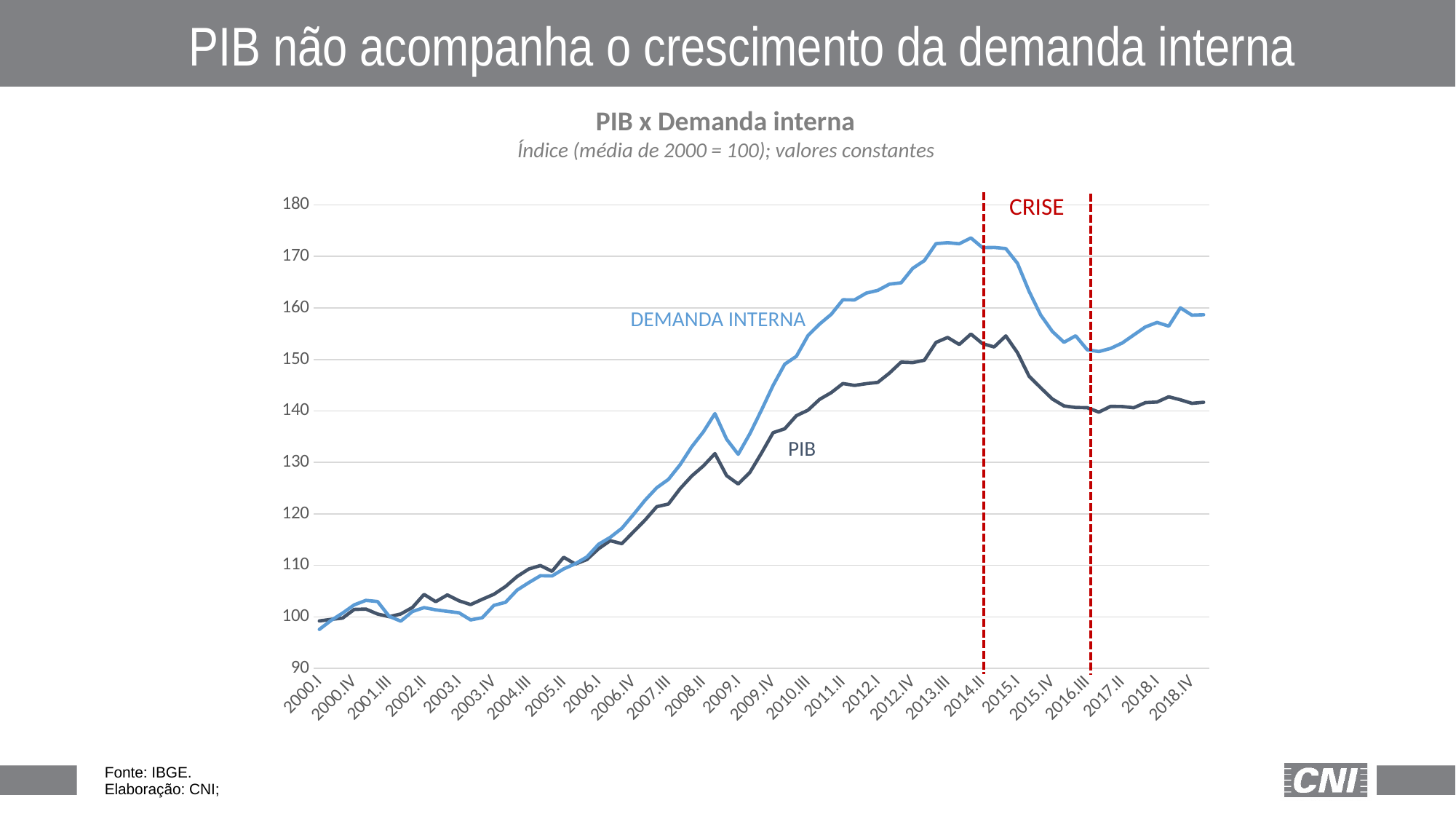
Is the value of DEMANDA INTERNA at 2018.IV greater or less than 150? greater At 2018.IV, which series has the higher value, PIB or DEMANDA INTERNA? DEMANDA INTERNA What word is written in red between the two dashed vertical lines? CRISE What kind of chart is shown on the slide? Line chart Is the value of PIB at 2000.I greater or less than 110? less Is the value of DEMANDA INTERNA at 2013.III greater or less than 170? greater How many series are plotted in the chart? 2 What is the title of the chart? PIB x Demanda interna Which series reaches the higher peak value over the whole period? DEMANDA INTERNA Do the PIB values rise or fall between 2014.II and 2016.III? fall